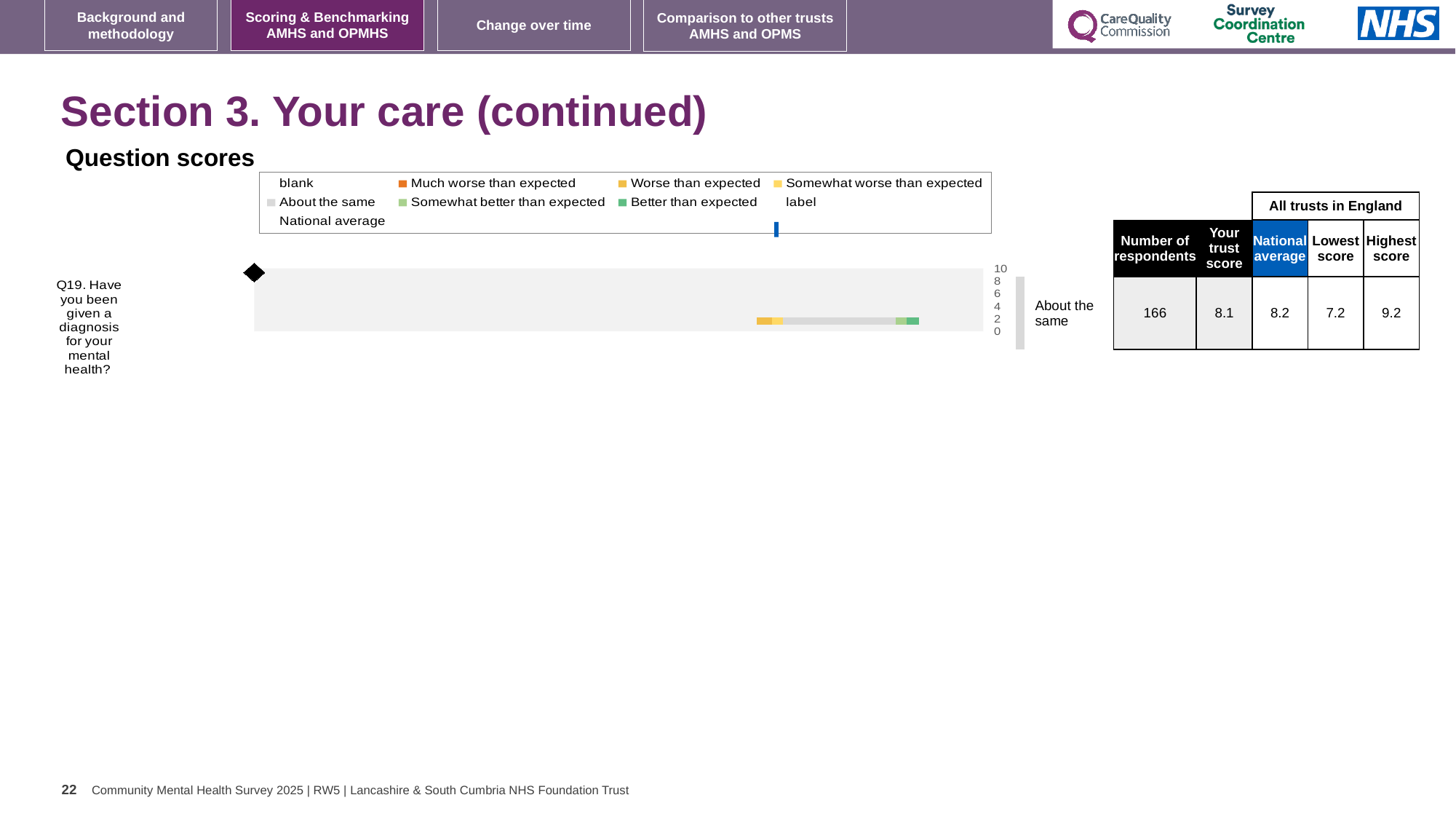
What is the difference between the highest and lowest scores among all trusts in England for Q19? 2.0 What kind of chart is shown under 'Question scores'? bar chart What is the highest score among all trusts in England for Q19? 9.2 What is the lowest score among all trusts in England for Q19? 7.2 What is the trust's score for Q19? 8.1 What benchmark category is shown for Q19 in the Question scores chart? About the same What is the national average score for Q19? 8.2 How many survey questions are plotted in the Question scores chart? 1 In the legend of the Question scores chart, what colour represents 'Much worse than expected'? orange Which question is plotted in the Question scores chart? Q19. Have you been given a diagnosis for your mental health? Which is larger for Q19, the trust's score or the national average? national average What is the number of respondents for Q19? 166